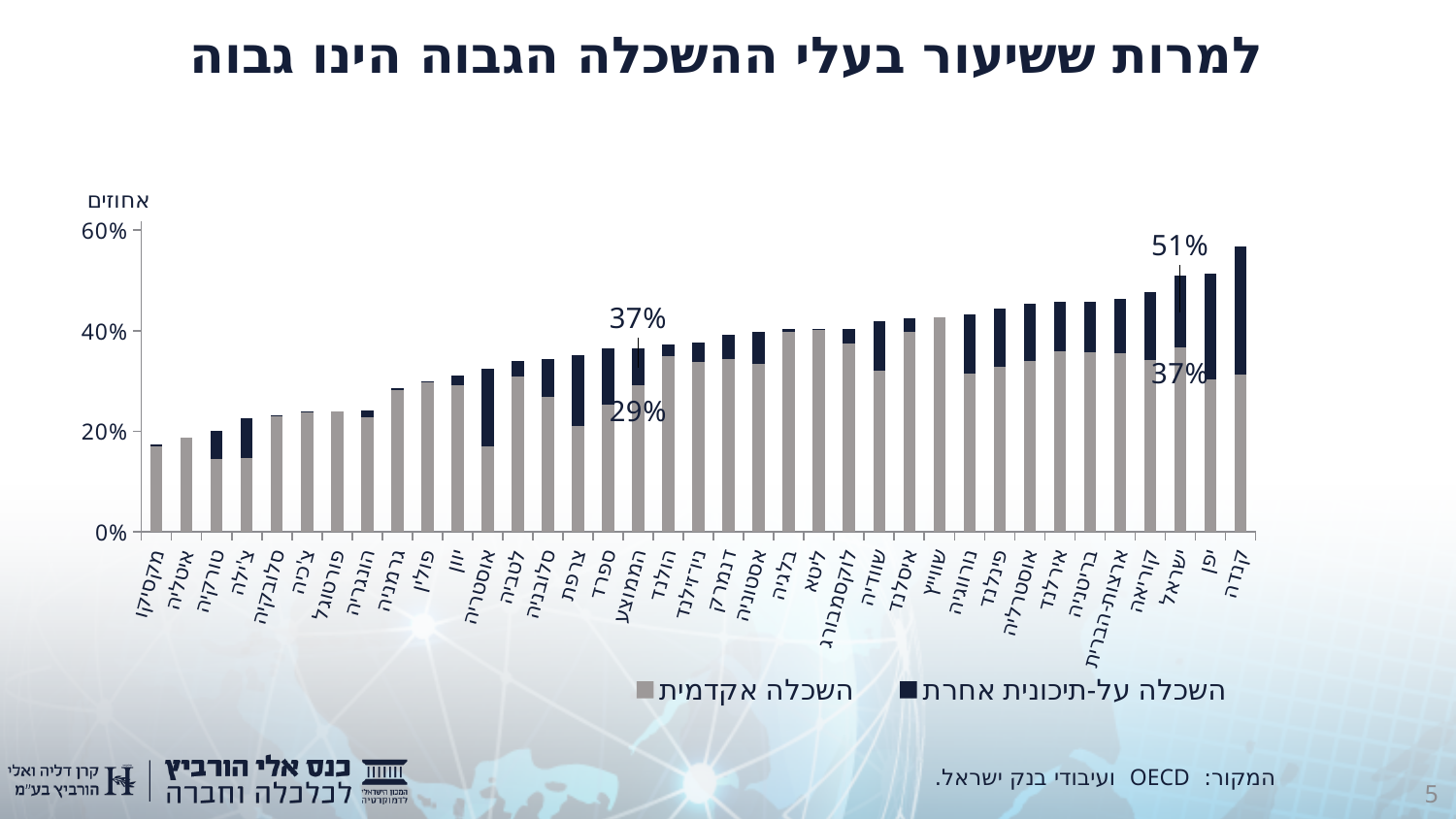
Is the total value for מקסיקו greater or less than 20%? less What is the label on the vertical axis? אחוזים Is the total value for קנדה greater or less than 40%? greater Which country has the highest total bar? קנדה How many series does the legend list? 2 What kind of chart is shown on the slide? Stacked bar chart What are the two series named in the legend? השכלה על-תיכונית אחרת and השכלה אקדמית What is the highest value shown on the vertical axis? 60% What is the lowest data label printed on the chart? 29% What is the highest data label printed on the chart? 51% Do the total bar heights generally rise or fall from left to right along the x axis? rise Which country has the lowest total bar? מקסיקו